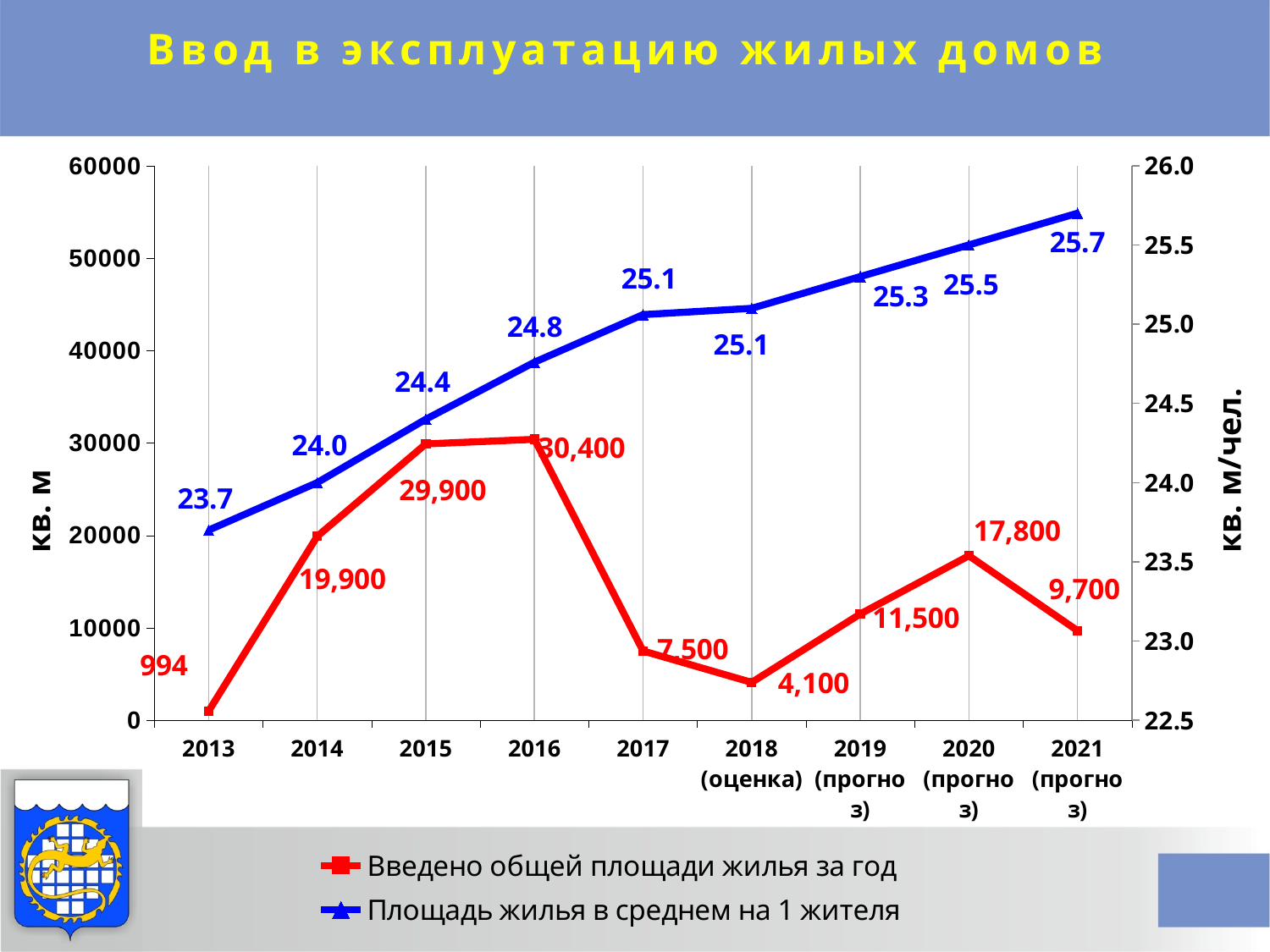
What is the value of "Введено общей площади жилья за год" for 2016? 30,400 Does "Площадь жилья в среднем на 1 жителя" rise or fall from 2013 to 2021? rise How many series does the legend list? 2 What kind of chart is shown on the slide? line chart Which is larger: "Введено общей площади жилья за год" in 2014 or in 2019 (прогноз)? 2014 In which year is "Введено общей площади жилья за год" the highest? 2016 What is the value of "Площадь жилья в среднем на 1 жителя" for 2013? 23.7 What is the value of "Введено общей площади жилья за год" for 2018 (оценка)? 4,100 In which year is "Введено общей площади жилья за год" the lowest? 2013 What is the title of the chart? Ввод в эксплуатацию жилых домов What is the difference between the "Введено общей площади жилья за год" values for 2020 (прогноз) and 2021 (прогноз)? 8,100 How many years are shown on the x axis? 9